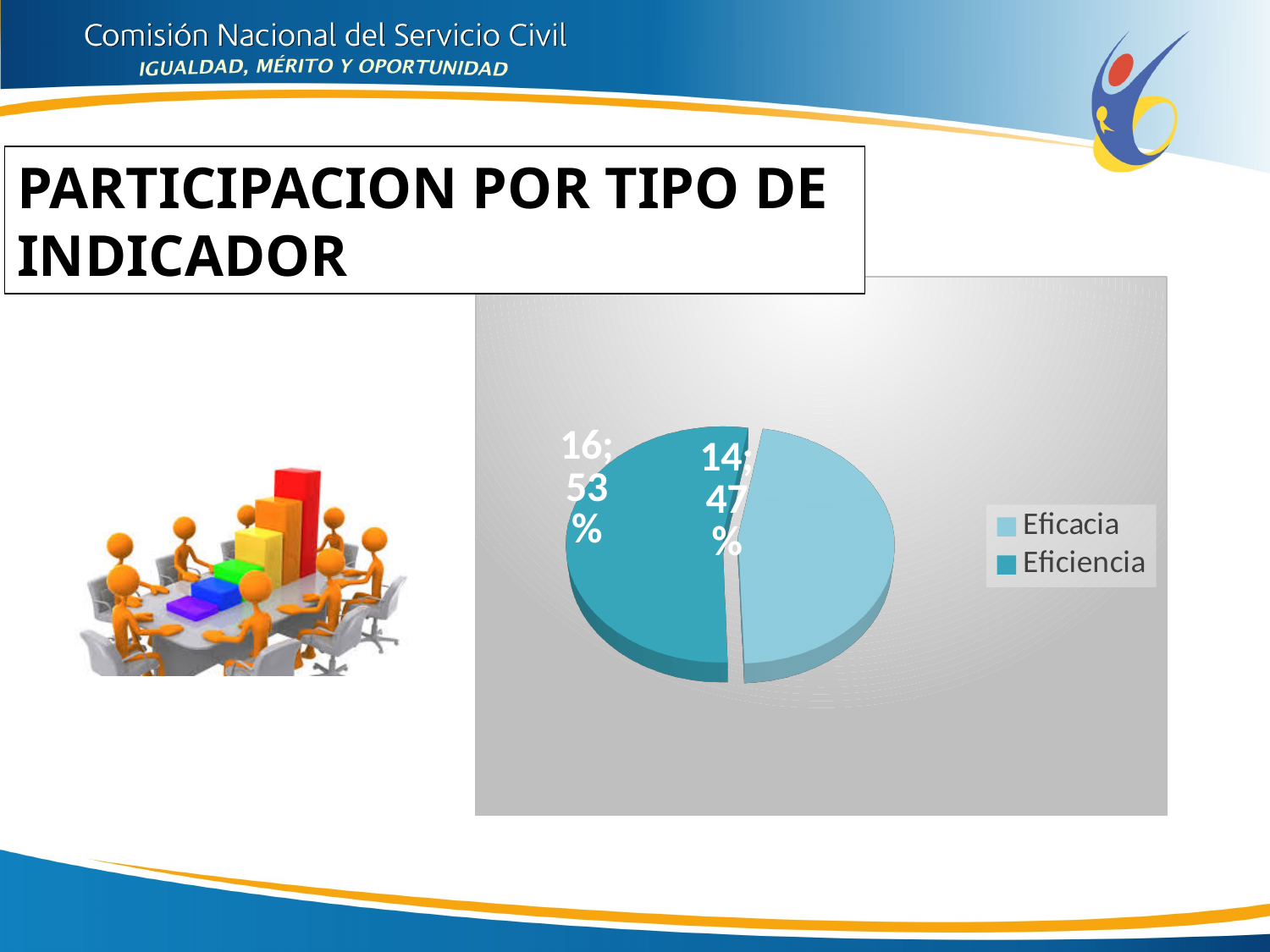
What is the count value shown for Eficacia in the pie chart? 14 How many entries does the legend of the pie chart list? 2 What are the two legend entries of the pie chart? Eficacia, Eficiencia What kind of chart is shown on the slide? pie chart What is the count value shown for Eficiencia in the pie chart? 16 Which category has the largest slice in the pie chart? Eficiencia What percentage share does the Eficacia slice have in the pie chart? 47% What percentage share does the Eficiencia slice have in the pie chart? 53% Which is larger in the pie chart, Eficacia or Eficiencia? Eficiencia What is the difference between the count values for Eficiencia and Eficacia in the pie chart? 2 How many slices does the pie chart have? 2 Which category has the smallest slice in the pie chart? Eficacia